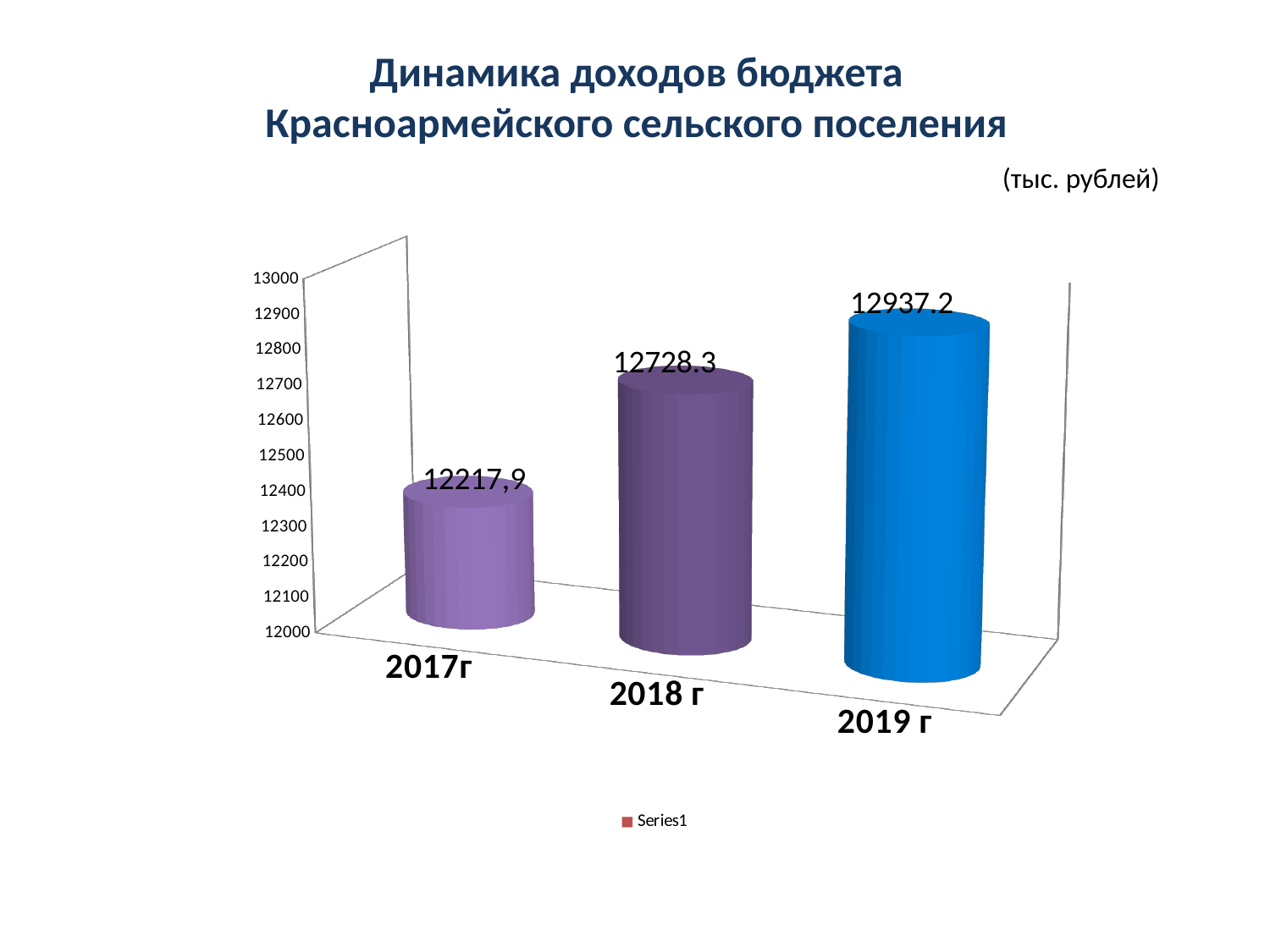
Which is larger, the value for 2018 г or the value for 2017г? 2018 г What is the difference between the values for 2019 г and 2018 г? 208.9 What is the value for 2017г? 12217,9 How many years are shown on the chart? 3 How many series does the legend list? 1 Is the value for 2018 г greater or less than 12500? greater What kind of chart is shown on the slide? bar chart What is the value for 2019 г? 12937.2 Which year has the lowest value? 2017г Do the values rise or fall from 2017г to 2019 г? rise What is the value for 2018 г? 12728.3 Which year has the highest value? 2019 г